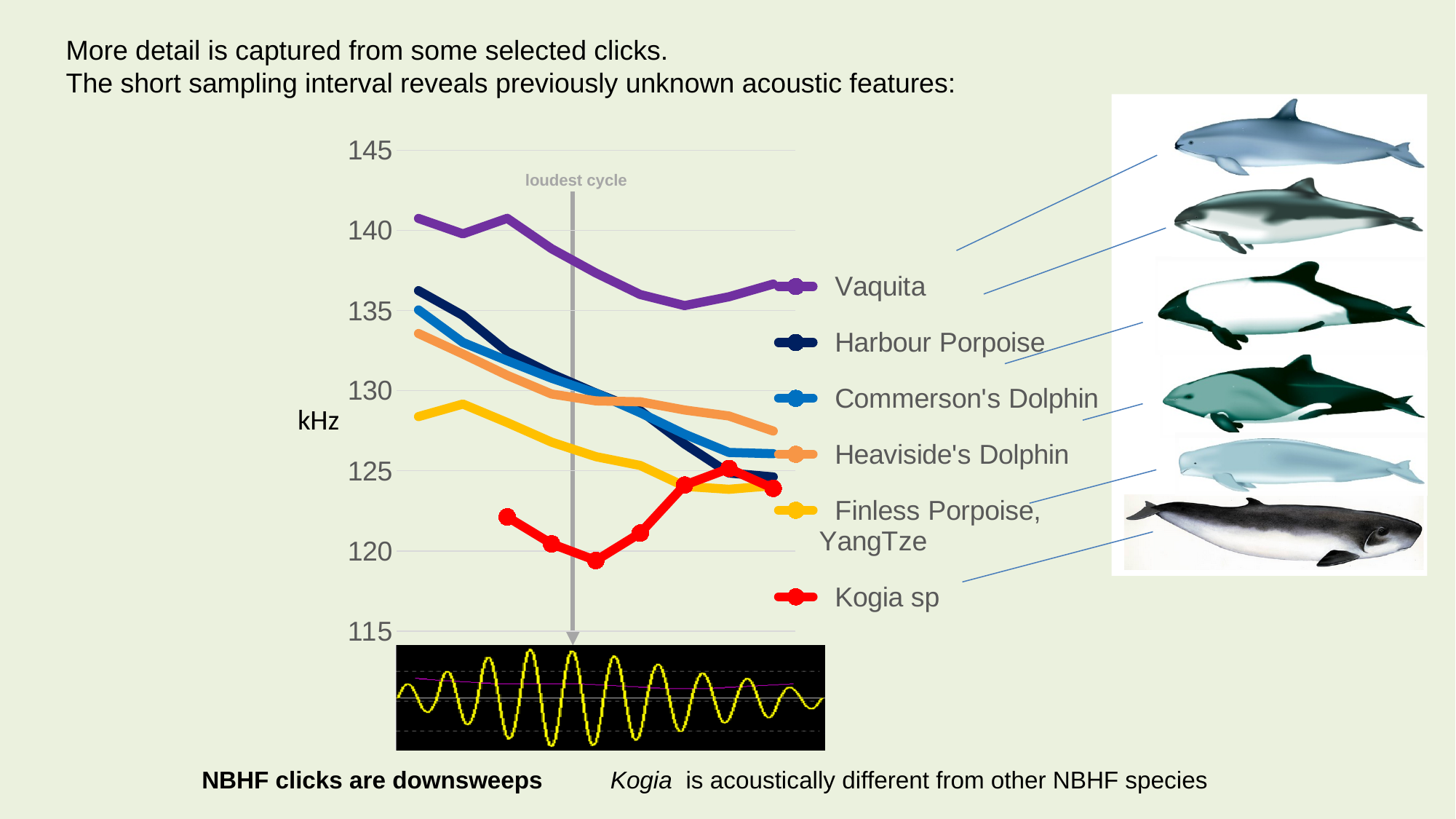
At the loudest cycle, which is higher: Vaquita or Harbour Porpoise? Vaquita How many series does the chart's legend list? 6 Is the Vaquita value at the loudest cycle greater or less than 135? greater What kind of chart is shown on the slide? line chart What colour is the Kogia sp line in the chart? red Do the Harbour Porpoise values rise or fall along the x axis? fall Do the Commerson's Dolphin values rise or fall along the x axis? fall Is the Kogia sp value at the loudest cycle greater or less than 125? less Which series has the highest frequency values across the chart? Vaquita Which series has the lowest frequency value at the loudest cycle? Kogia sp Is the first Finless Porpoise, YangTze value greater or less than 130? less What unit is shown on the y axis of the chart? kHz